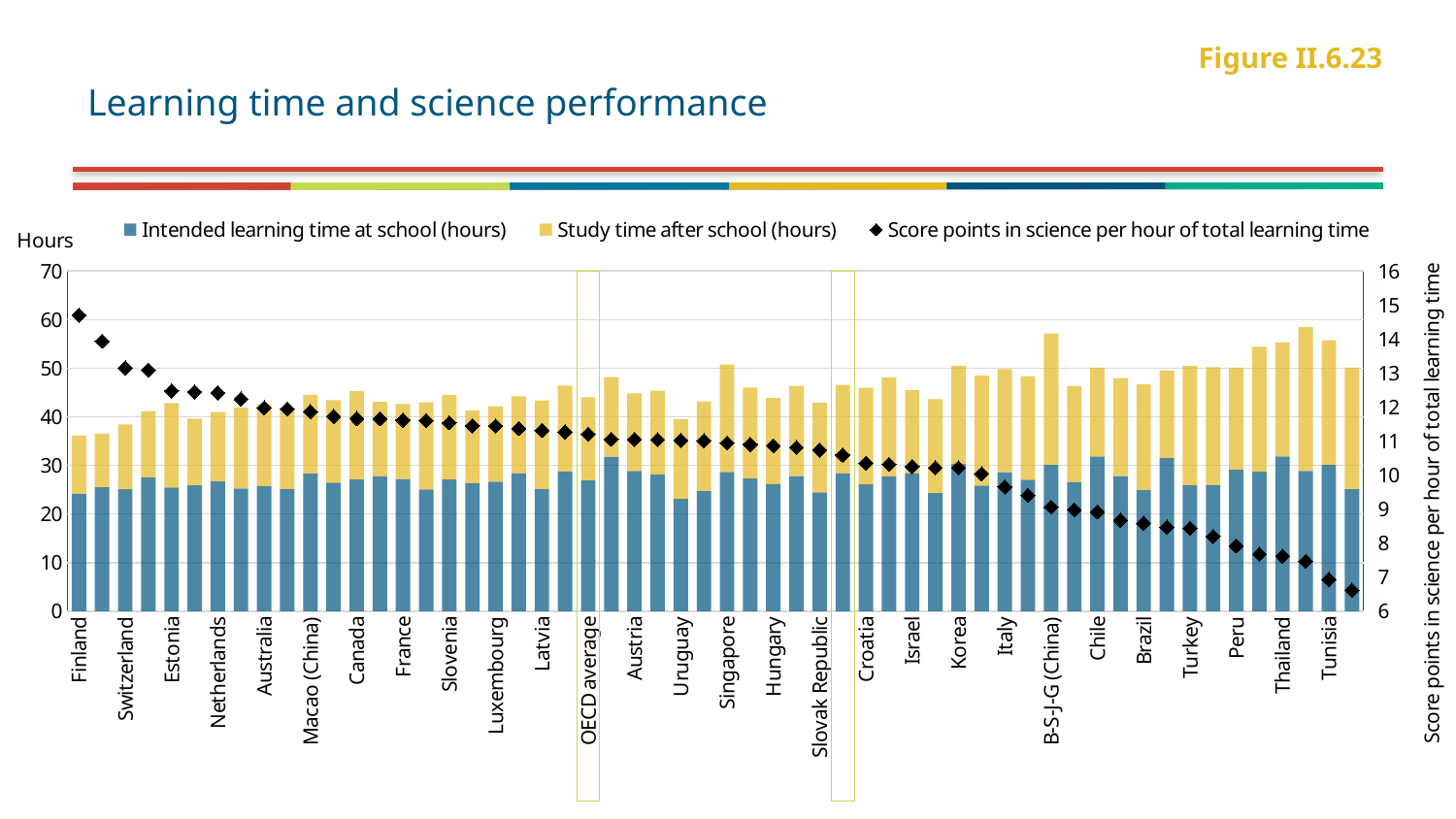
Which country has the highest score points in science per hour of total learning time? Finland Is the total learning time (stacked bar) for Thailand greater or less than 50 hours? greater Which has the taller total stacked bar, Finland or Thailand? Thailand How many series does the legend list? 3 Is the score points in science per hour of total learning time for Tunisia greater or less than 8? less Is the score points in science per hour of total learning time for Finland greater or less than 14? greater What is the title of the chart? Learning time and science performance Which has the higher score points in science per hour of total learning time, Finland or Tunisia? Finland Which series is shown in yellow in the legend? Study time after school (hours) What kind of chart is shown on the slide? A bar chart with stacked bars and a diamond marker series Do the diamond markers for score points in science per hour of total learning time rise or fall from left to right across the countries? Fall